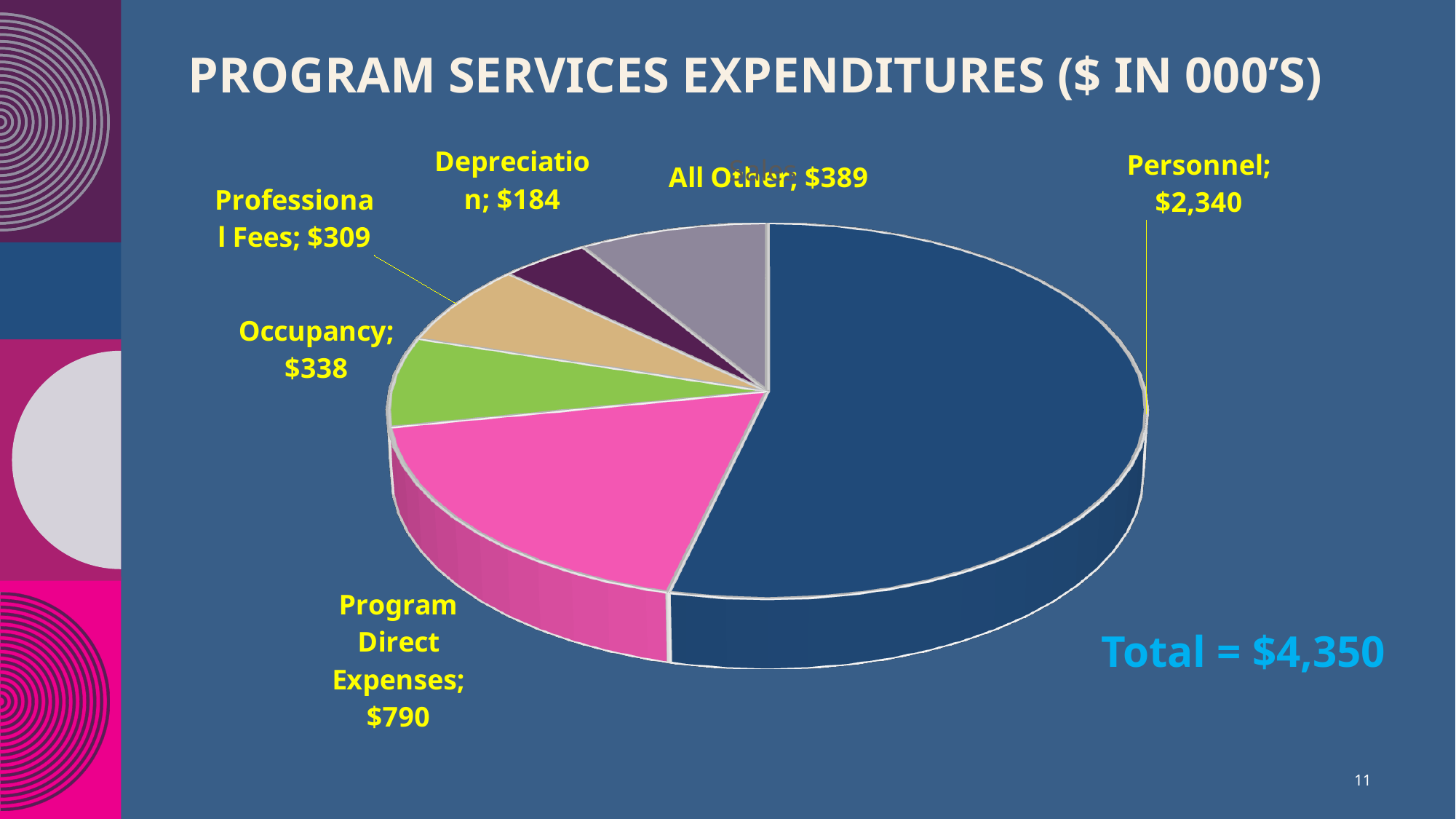
Which category has the largest expenditure? Personnel How many categories are shown in the pie chart? 6 What is the value for Program Direct Expenses? $790 What is the value for Depreciation? $184 Which is larger, Occupancy or Professional Fees? Occupancy What is the value for Occupancy? $338 What type of chart is shown on the slide? Pie chart What is the difference between Program Direct Expenses and All Other? $401 Which category has the smallest expenditure? Depreciation What is the title of the chart? PROGRAM SERVICES EXPENDITURES ($ IN 000'S) What is the value for Personnel? $2,340 What is the total of all program services expenditures shown on the slide? $4,350